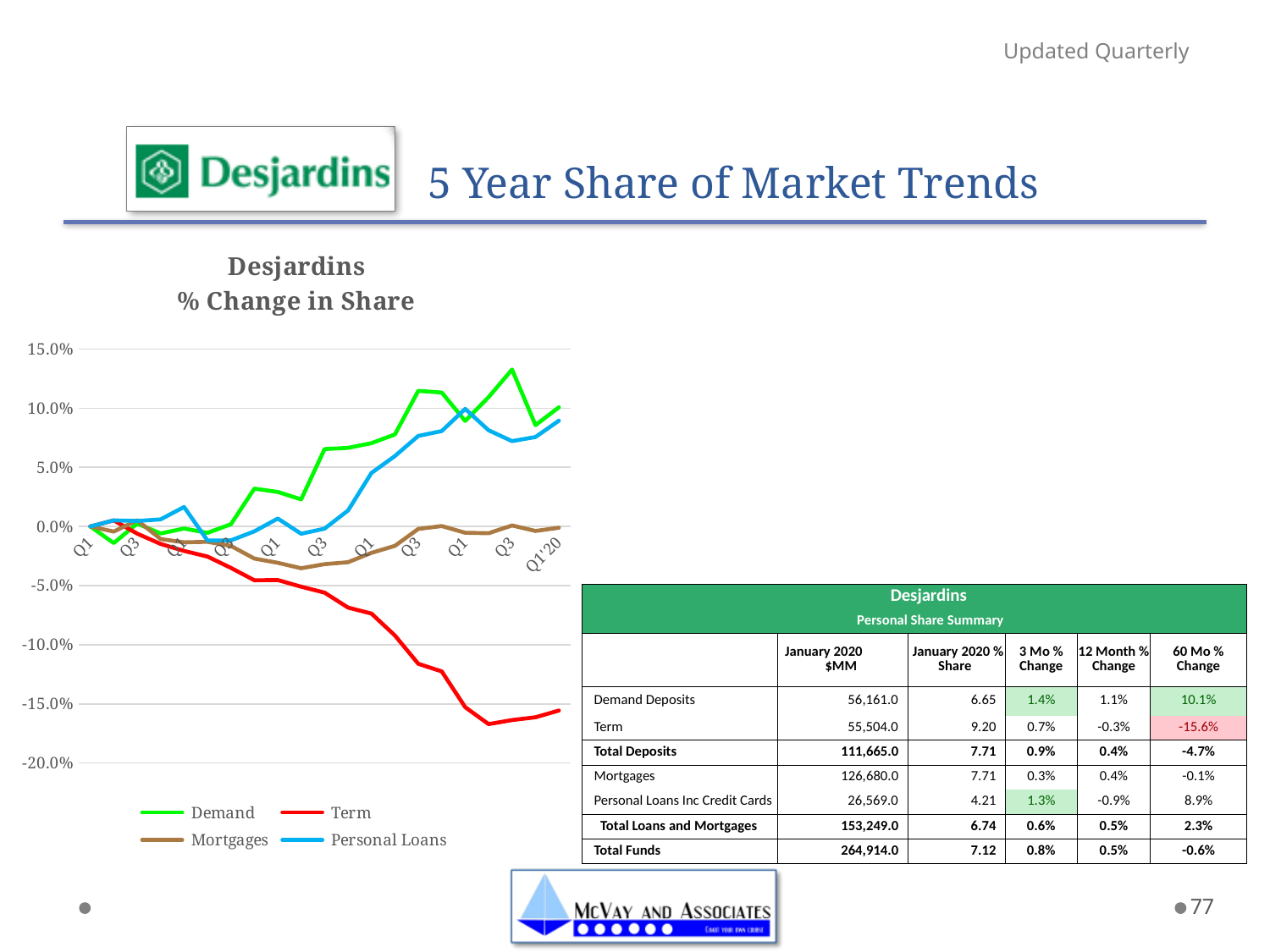
Does the Term line generally rise or fall from left to right across the chart? fall Is the lowest point of the Term line greater or less than -15.0%? less What kind of chart is shown on the slide? line chart Is the value for Demand at Q1'20 greater or less than 5.0%? greater What colour is the Term line in the chart? red Which series has the lowest value at Q1'20? Term Does the Demand line generally rise or fall from left to right across the chart? rise At Q1'20, which is larger: the Demand value or the Term value? Demand Is the value for Term at Q1'20 greater or less than -10.0%? less Which series are listed in the chart's legend? Demand, Term, Mortgages, Personal Loans How many series does the legend of the chart list? 4